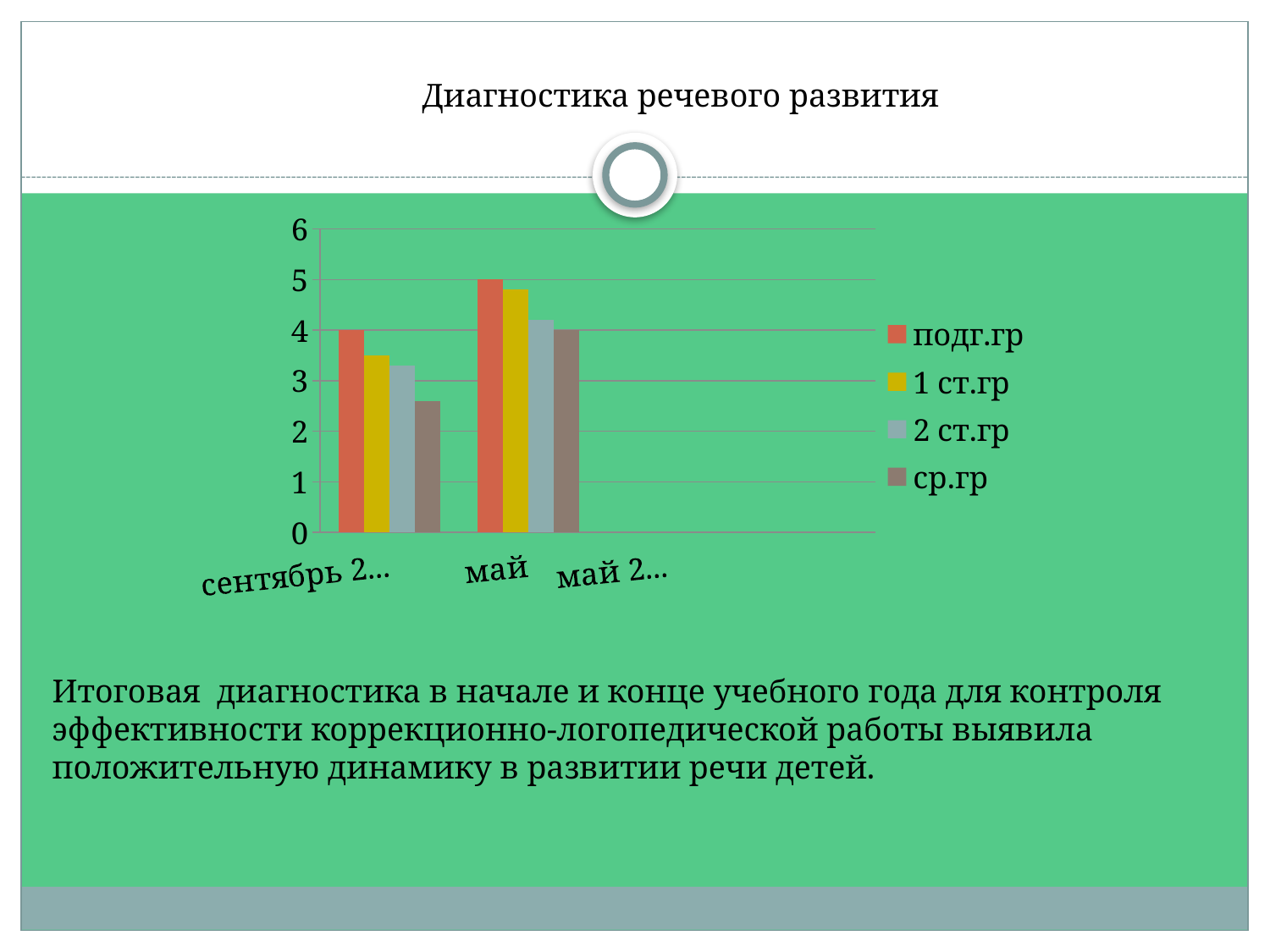
How many series does the chart legend list? 4 Is the value for 1 ст.гр in the май category greater or less than 4? greater Is the value for 2 ст.гр in the сентябрь category greater or less than 4? less Which series is shown in red in the chart legend? подг.гр What is the title of the slide with the chart? Диагностика речевого развития Is the value for ср.гр in the сентябрь category greater or less than 3? less Which series has the highest value in the май category? подг.гр What kind of chart is shown on the slide? bar chart Does the value for ср.гр rise or fall from сентябрь to май? rise Is the value for подг.гр larger in сентябрь or in май? май Which series has the lowest value in the сентябрь category? ср.гр Which series has the highest value in the сентябрь category? подг.гр